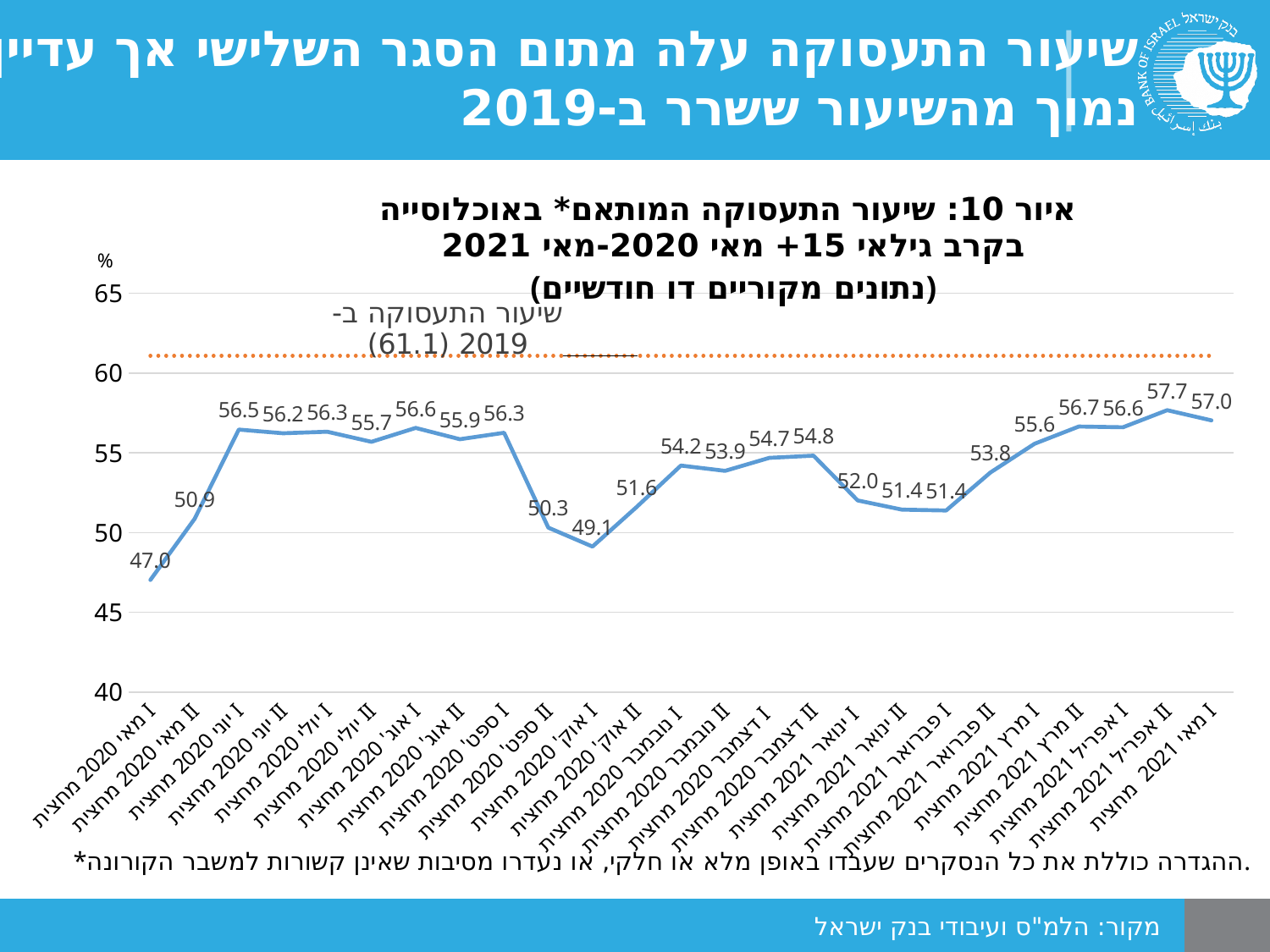
Which is larger: the employment rate in the first half of September 2020 or the first half of October 2020? first half of September 2020 (56.3) What is the employment rate for the second half of October 2020 (מחצית II אוק' 2020)? 51.6 What is the employment rate for the first half of May 2021 (מחצית I מאי 2021)? 57.0 How many data points are plotted on the line? 25 What value does the dotted orange reference line represent, according to its label? the 2019 employment rate (61.1) Does the employment rate rise or fall between the first half of October 2020 and the second half of December 2020? rise What is the difference between the employment rate in the second half of April 2021 (57.7) and the first half of May 2020 (47.0)? 10.7 Is the employment rate for the second half of October 2020 greater or less than 50? greater What is the employment rate for the first half of May 2020 (מחצית I מאי 2020)? 47.0 Which period has the lowest employment rate on the chart? מחצית I מאי 2020 (47.0) Which period has the highest employment rate on the chart? מחצית II אפריל 2021 (57.7) What type of chart is shown on the slide? line chart